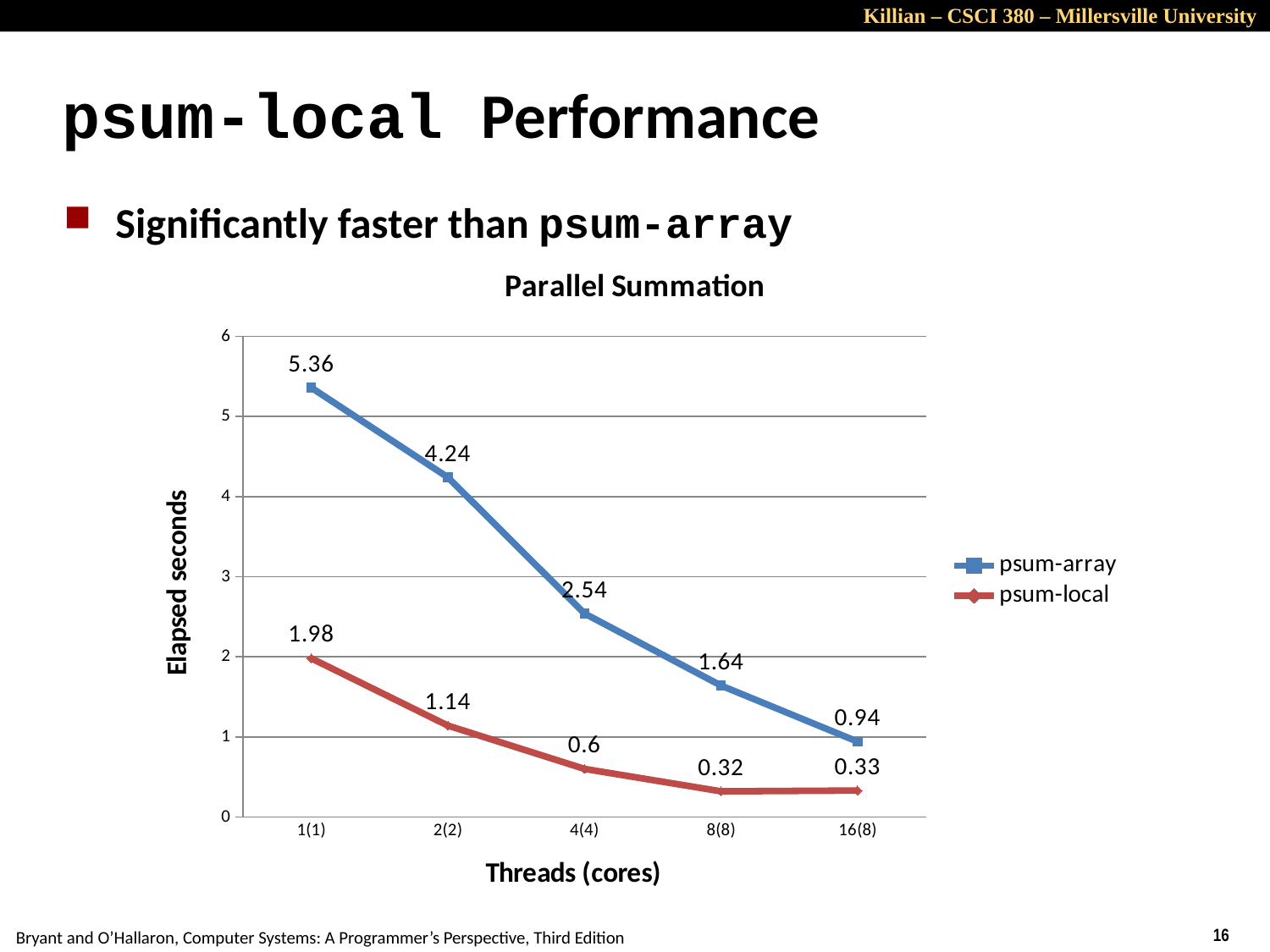
How many series does the legend list? 2 Is the elapsed seconds value for psum-array at 4(4) threads (cores) greater or less than 2? greater Which series has the larger elapsed seconds at 8(8) threads (cores), psum-array or psum-local? psum-array What is the elapsed seconds value for psum-local at 4(4) threads (cores)? 0.6 Does the elapsed seconds value for psum-array rise or fall as threads (cores) increase from 1(1) to 16(8)? fall At which threads (cores) setting does psum-array have its highest elapsed seconds? 1(1) What is the difference in elapsed seconds between psum-array and psum-local at 2(2) threads (cores)? 3.1 What kind of chart is shown on the slide? line chart At which threads (cores) setting does psum-local have its lowest elapsed seconds? 8(8) What is the elapsed seconds value for psum-array at 1(1) threads (cores)? 5.36 How many threads (cores) settings are plotted on the x axis? 5 What is the elapsed seconds value for psum-array at 16(8) threads (cores)? 0.94